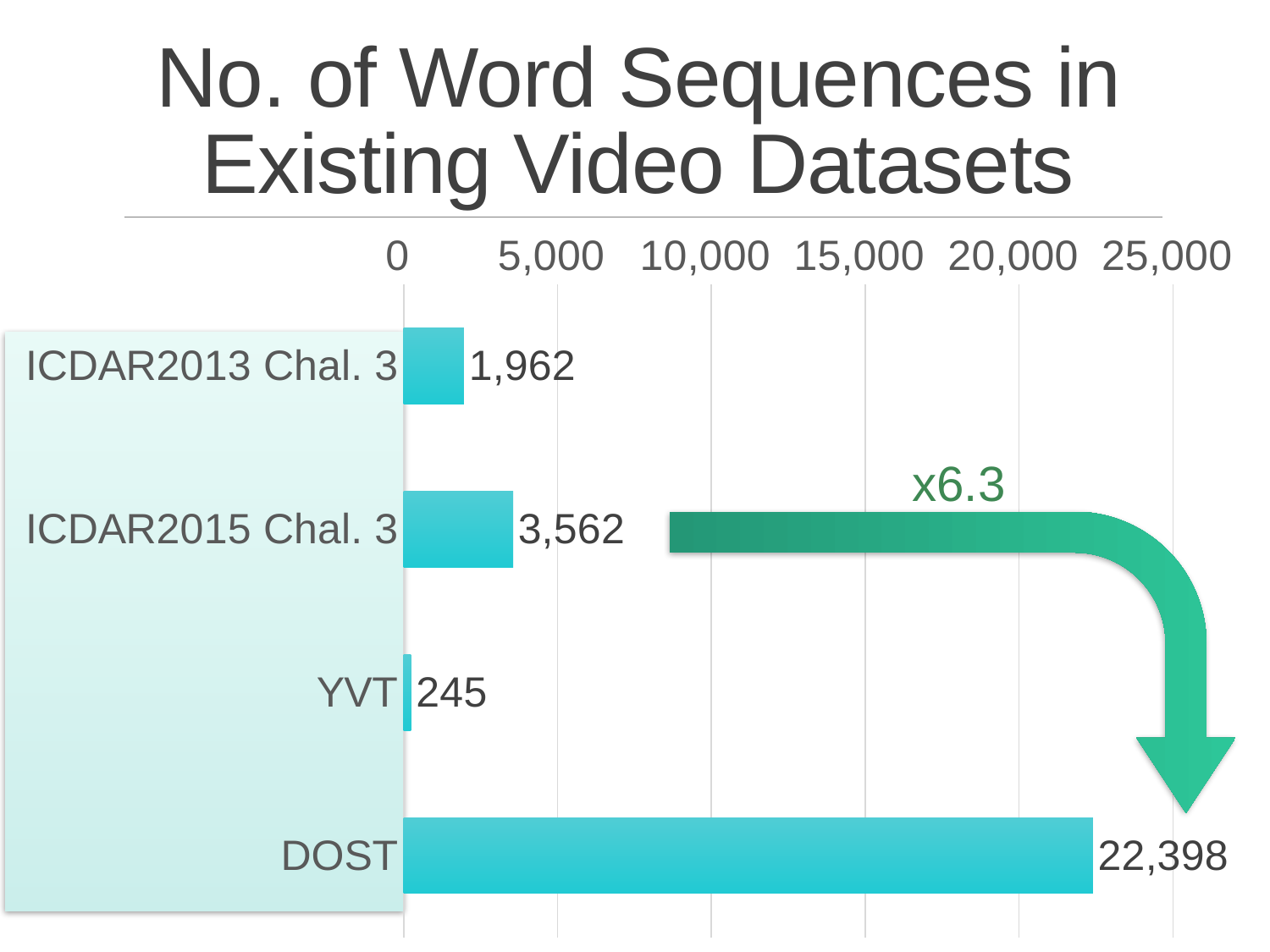
What kind of chart is shown on the slide? Bar chart What is the difference in word sequences between ICDAR2015 Chal. 3 and ICDAR2013 Chal. 3? 1,600 Which dataset has the highest number of word sequences? DOST What is the number of word sequences for YVT? 245 What is the number of word sequences for DOST? 22,398 What is the number of word sequences for ICDAR2013 Chal. 3? 1,962 Which dataset has the lowest number of word sequences? YVT What is the number of word sequences for ICDAR2015 Chal. 3? 3,562 What is the title of the chart? No. of Word Sequences in Existing Video Datasets Which has more word sequences, ICDAR2013 Chal. 3 or ICDAR2015 Chal. 3? ICDAR2015 Chal. 3 What is the difference in word sequences between DOST and ICDAR2015 Chal. 3? 18,836 How many datasets are shown in the chart? 4